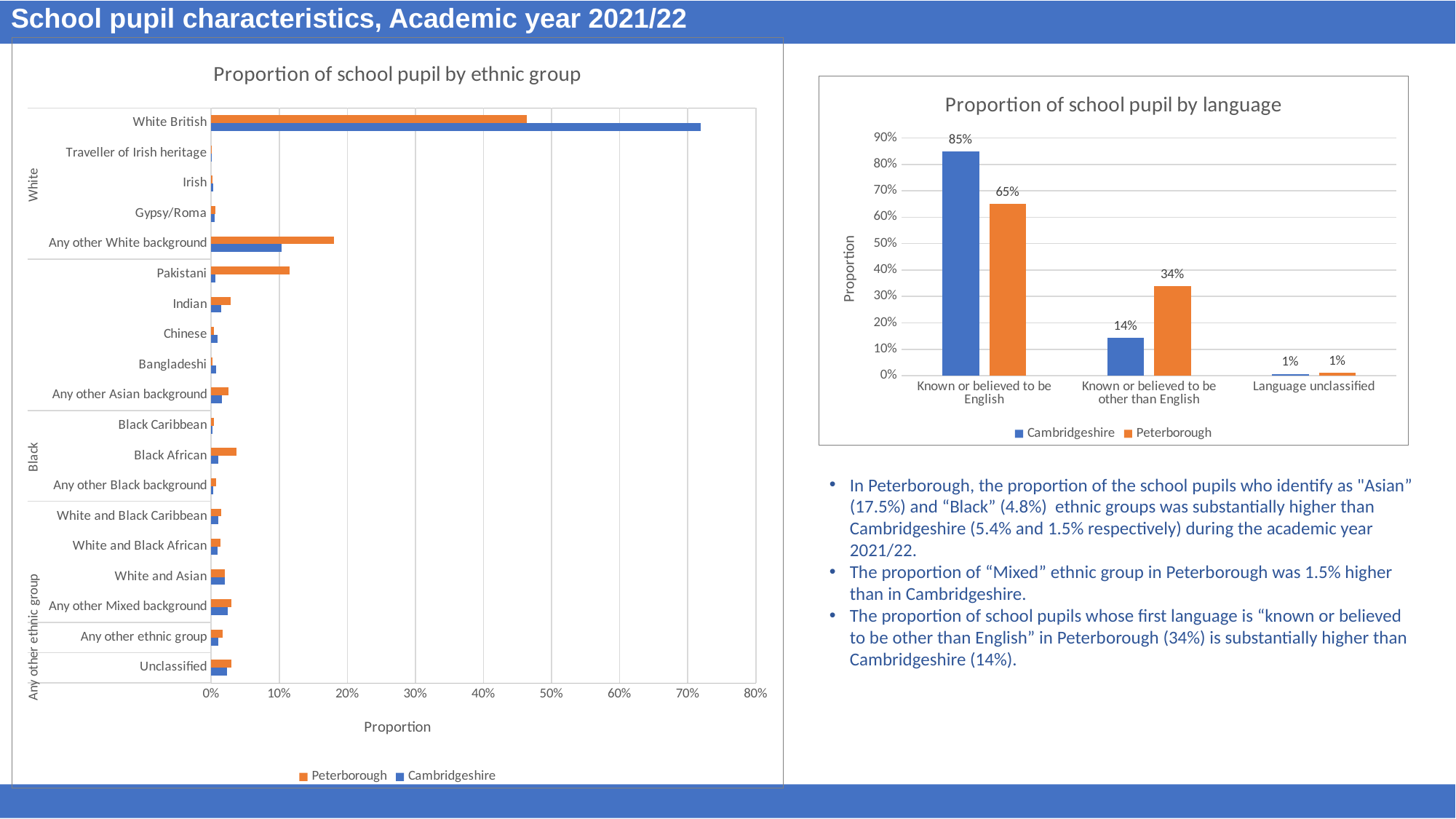
In the 'Proportion of school pupil by language' chart, what is the value for Peterborough for 'Known or believed to be other than English'? 34% In the 'Proportion of school pupil by language' chart, how many series does the legend list? 2 In the 'Proportion of school pupil by ethnic group' chart, is the Peterborough value for 'Any other White background' greater or less than 10%? greater In the 'Proportion of school pupil by language' chart, which is larger for 'Known or believed to be English': Cambridgeshire or Peterborough? Cambridgeshire What kind of chart is the 'Proportion of school pupil by ethnic group' chart? Bar chart In the 'Proportion of school pupil by language' chart, what is the value for Cambridgeshire for 'Known or believed to be other than English'? 14% In the 'Proportion of school pupil by language' chart, what is the value for Cambridgeshire for 'Known or believed to be English'? 85% In the 'Proportion of school pupil by language' chart, how many categories are shown on the x axis? 3 In the 'Proportion of school pupil by language' chart, which category has the highest value for Peterborough? Known or believed to be English In the 'Proportion of school pupil by language' chart, what is the difference between Peterborough and Cambridgeshire for 'Known or believed to be other than English'? 20 percentage points In the 'Proportion of school pupil by ethnic group' chart, which ethnic group has the highest proportion for Cambridgeshire? White British In the 'Proportion of school pupil by ethnic group' chart, is the Peterborough value for 'White British' greater or less than 50%? less